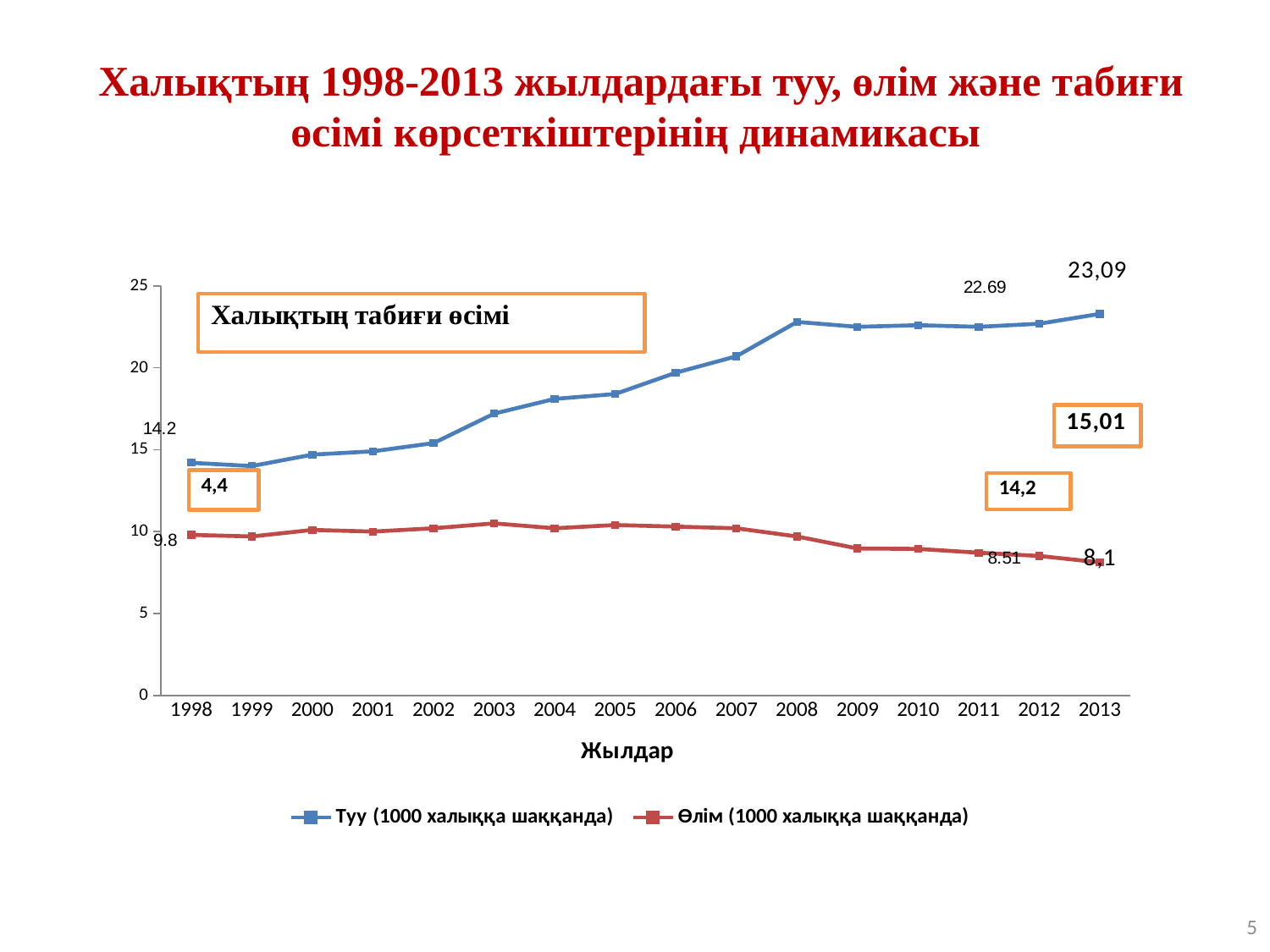
What is the value of Туу (1000 халыққа шаққанда) in 1998? 14.2 What is the difference between the Туу and Өлім values in 1998? 4.4 How many series does the legend list? 2 Which is larger in 2011, the Туу value or the Өлім value? Туу How many years are shown on the x axis? 16 What is the value of Туу (1000 халыққа шаққанда) in 2013? 23,09 Is the value for Өлім in 2009 greater or less than 10? less In which year is the Өлім (1000 халыққа шаққанда) series at its lowest? 2013 Is the value for Туу in 2008 greater or less than 20? greater What is the value of Өлім (1000 халыққа шаққанда) in 2013? 8,1 What is the value of Өлім (1000 халыққа шаққанда) in 1998? 9.8